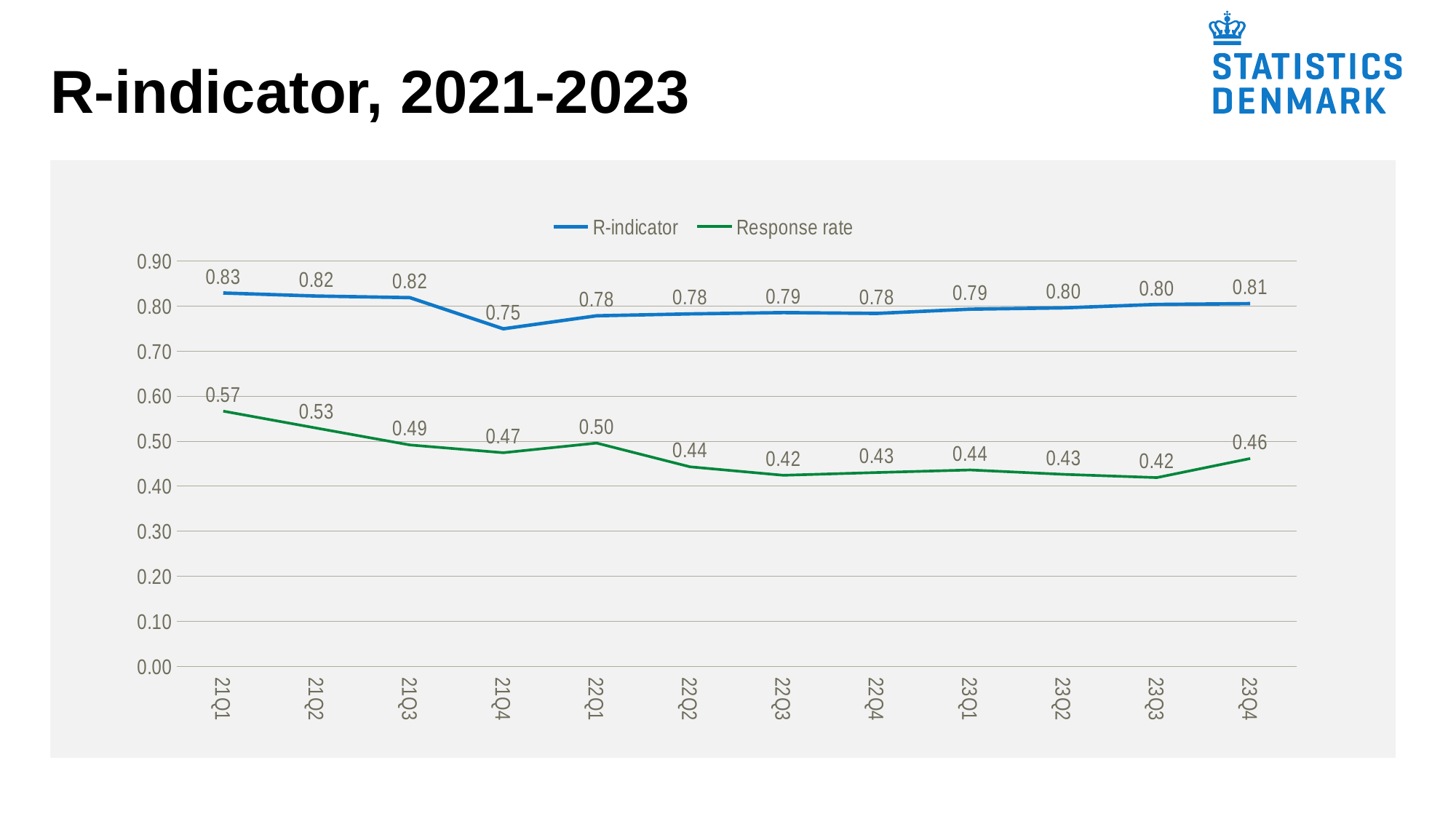
What is the difference between the Response rate in 21Q1 and in 21Q4? 0.10 How many series does the legend list? 2 What is the difference between the R-indicator and the Response rate in 23Q4? 0.35 Does the Response rate generally rise or fall from 21Q1 to 23Q3? Fall What is the Response rate for 23Q4? 0.46 How many quarters are shown on the x axis? 12 What kind of chart is shown on the slide? Line chart What is the R-indicator value for 21Q4? 0.75 In which quarter is the R-indicator lowest? 21Q4 Which is larger, the Response rate in 22Q1 or in 22Q2? 22Q1 What is the Response rate for 21Q1? 0.57 In which quarter is the Response rate highest? 21Q1